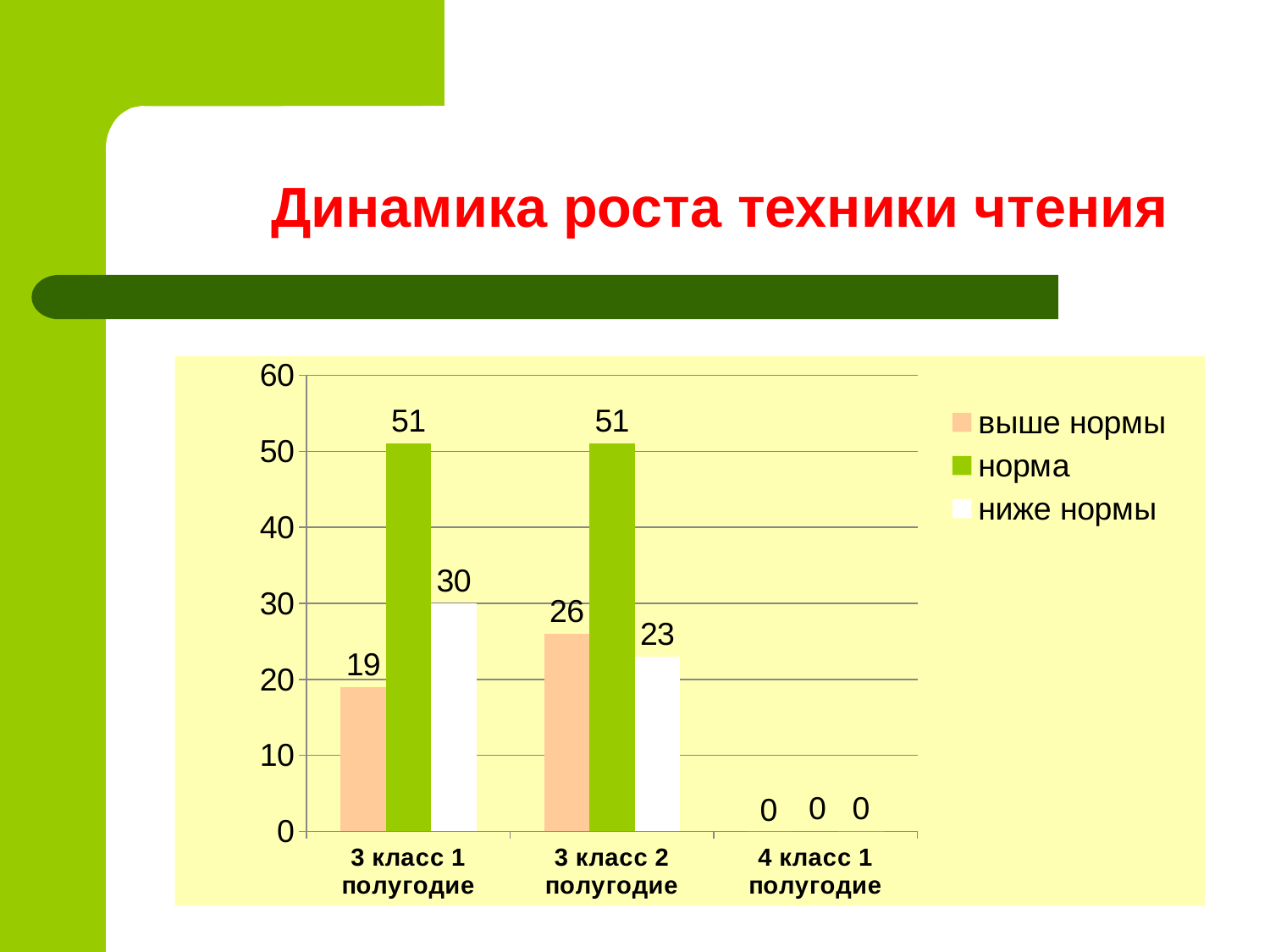
What is the value for "норма" in "3 класс 2 полугодие"? 51 Which series has the highest value in "3 класс 1 полугодие"? норма How many categories are shown on the x axis? 3 What is the value for "ниже нормы" in "3 класс 2 полугодие"? 23 Which series has the lowest value in "3 класс 1 полугодие"? выше нормы Which is larger: "выше нормы" in "3 класс 1 полугодие" or in "3 класс 2 полугодие"? 3 класс 2 полугодие How many series does the legend list? 3 What is the value for "выше нормы" in "3 класс 1 полугодие"? 19 What is the difference between "ниже нормы" in "3 класс 1 полугодие" and in "3 класс 2 полугодие"? 7 What is the title of the slide? Динамика роста техники чтения What kind of chart is shown on the slide? bar chart What is the value for "выше нормы" in "4 класс 1 полугодие"? 0